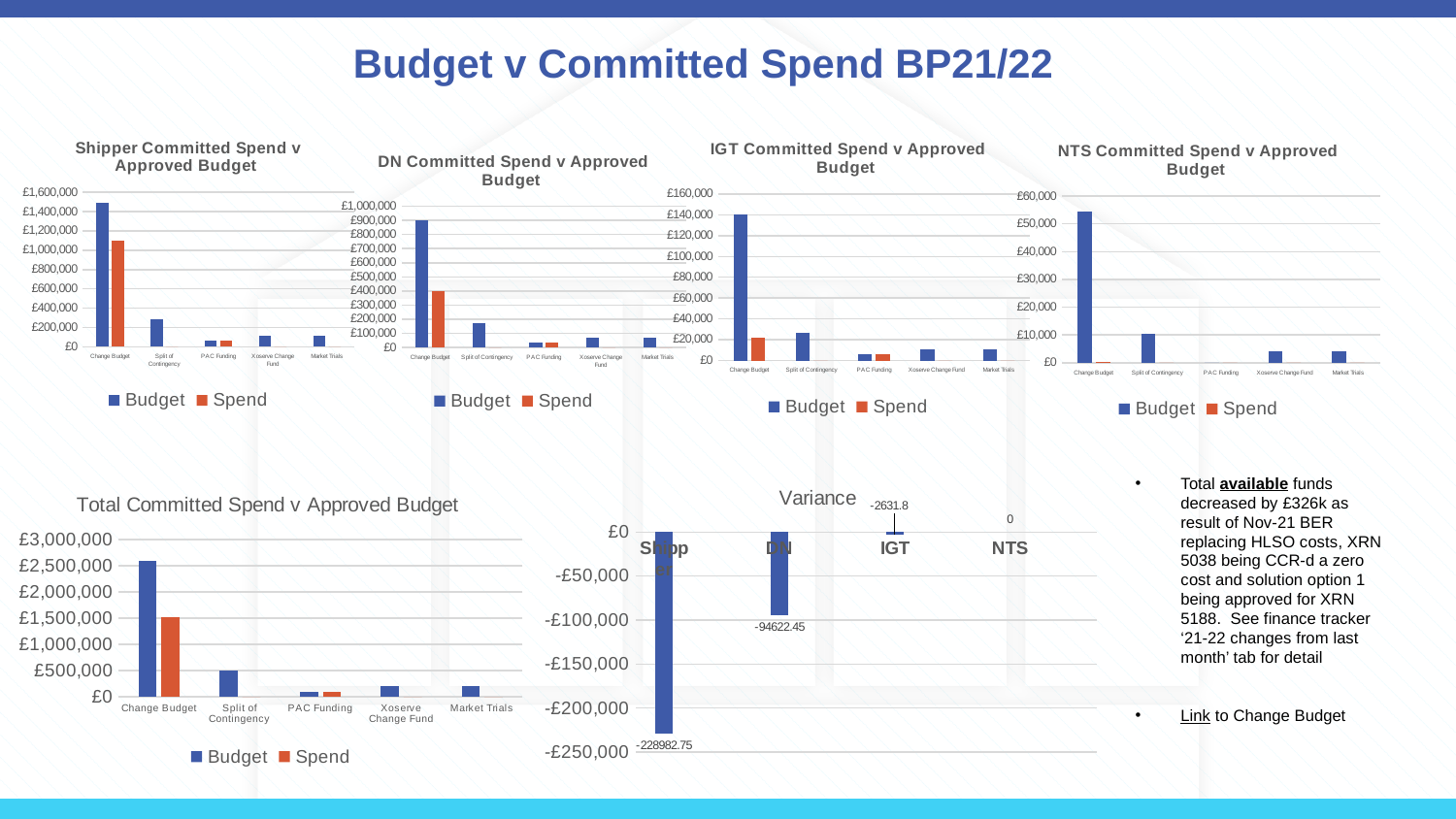
In the Variance chart, what is the value for NTS? 0 What kind of chart is the Total Committed Spend v Approved Budget chart? Bar chart In the Total Committed Spend v Approved Budget chart, which category has the highest Budget value? Change Budget In the Shipper Committed Spend v Approved Budget chart, how many categories are shown on the x axis? 5 In the Variance chart, what is the value for DN? -94622.45 In the IGT Committed Spend v Approved Budget chart, for Change Budget, which is larger: Budget or Spend? Budget In the Shipper Committed Spend v Approved Budget chart, how many series does the legend list? 2 In the Total Committed Spend v Approved Budget chart, is the Budget value for Change Budget greater or less than £2,000,000? greater In the Variance chart, which category has the lowest (most negative) value? Shipper In the DN Committed Spend v Approved Budget chart, is the Budget value for Change Budget greater or less than £800,000? greater In the Variance chart, what is the difference between the DN value and the Shipper value? 134360.30 In the Variance chart, what is the value for Shipper? -228982.75